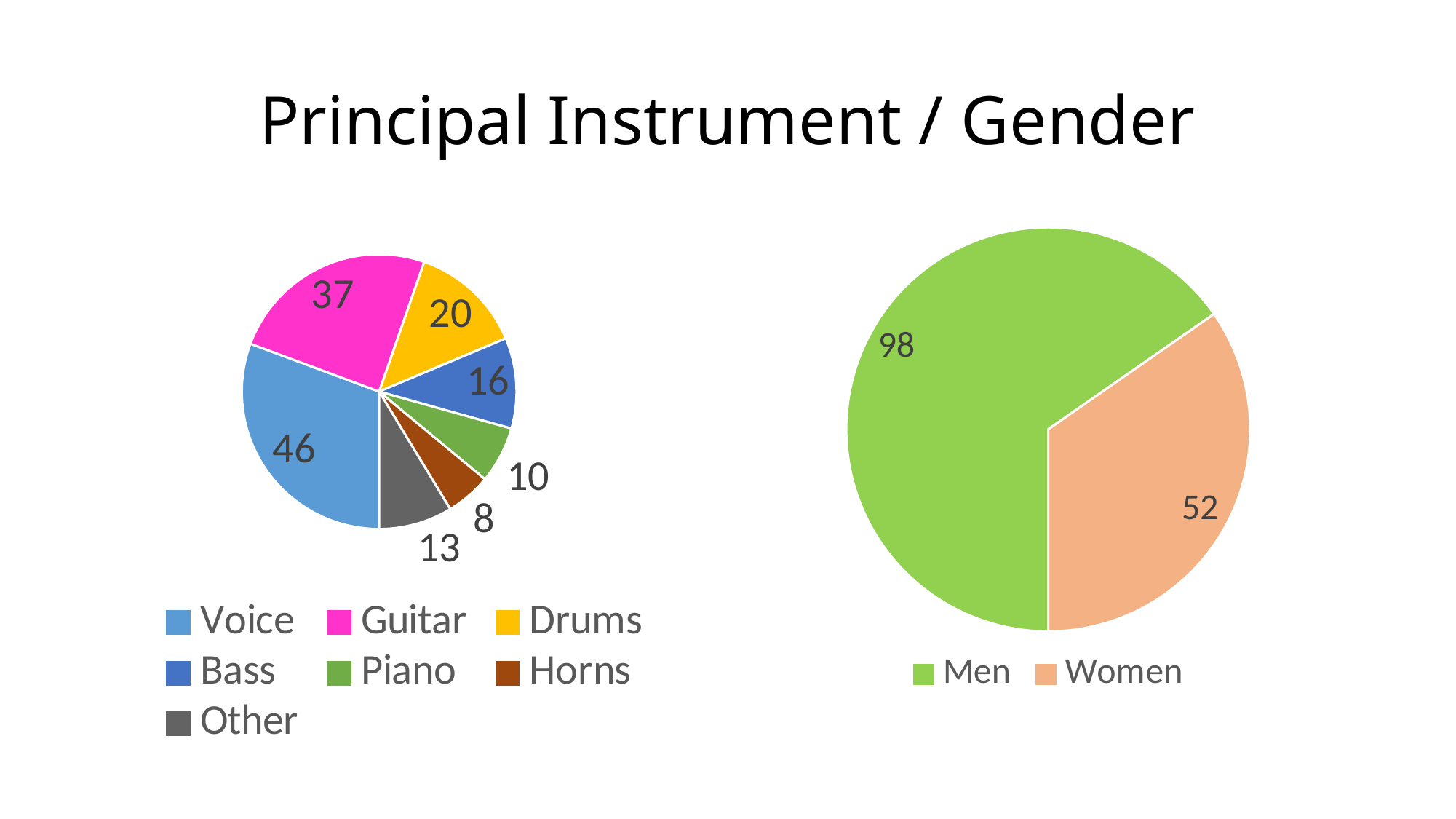
On the left pie chart, which category has the smallest slice? Horns How many categories does the left pie chart show? 7 On the left pie chart, what is the value for Voice? 46 On the left pie chart, which is larger, Bass or Piano? Bass On the left pie chart, what colour is the Guitar slice? Magenta (pink) On the left pie chart, what is the value for Drums? 20 On the left pie chart, which category has the largest slice? Voice On the left pie chart, what is the difference between the values for Voice and Guitar? 9 What type of chart is the chart on the right? Pie chart On the right pie chart, what share of the total do Men represent? 65.3% On the right pie chart, what is the difference between the values for Men and Women? 46 On the right pie chart, what is the value for Women? 52